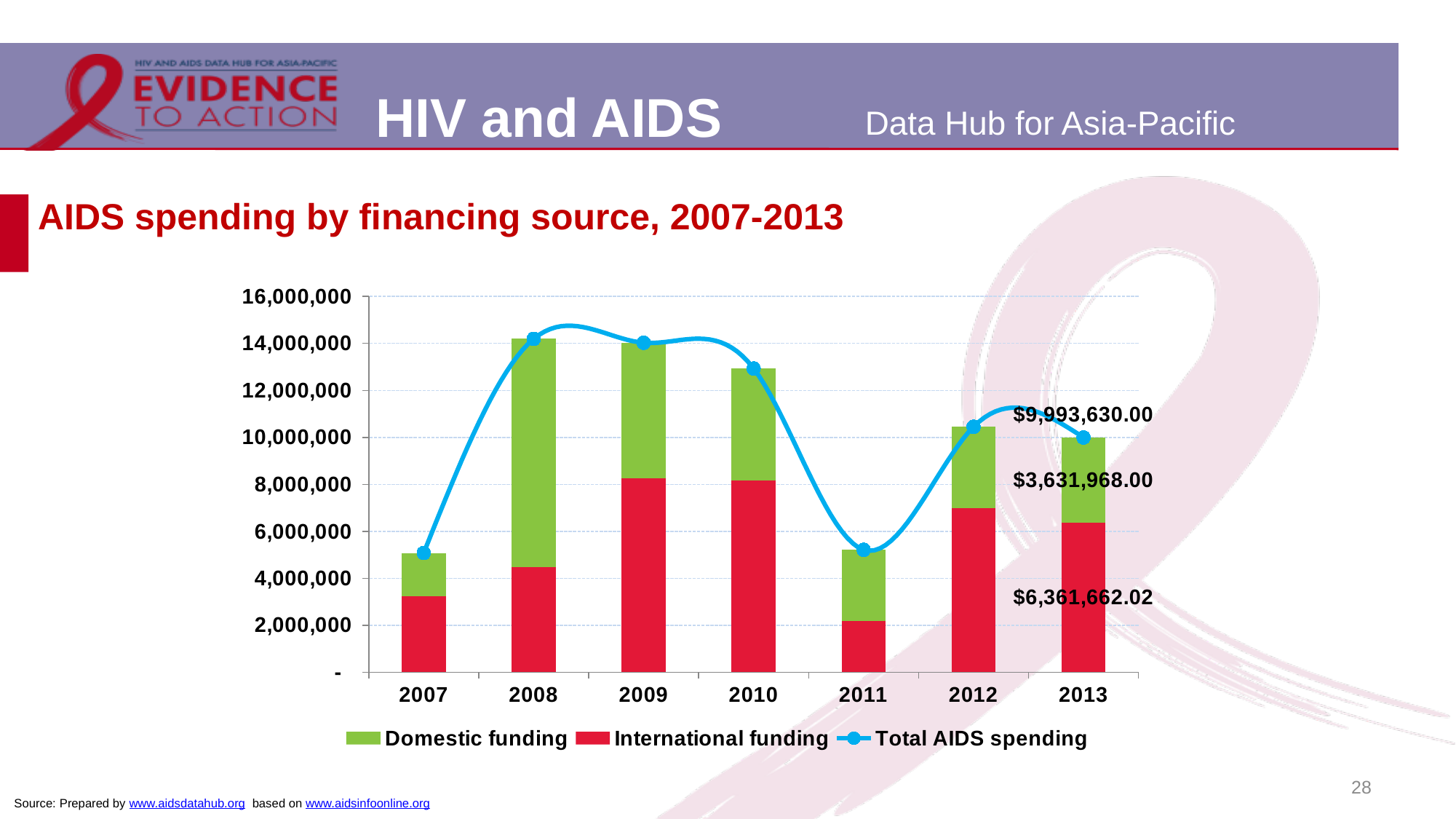
What is the domestic funding value labelled for 2013? $3,631,968.00 Is the total AIDS spending for 2011 greater or less than 6,000,000? less How many years are shown on the x axis? 7 Is the total AIDS spending for 2010 greater or less than 12,000,000? greater In 2013, which is larger: domestic funding or international funding? International funding What kind of chart is this? Stacked bar chart with a line Does total AIDS spending rise or fall from 2008 to 2011? Fall In 2008, which is larger: domestic funding or international funding? Domestic funding What is the international funding value labelled for 2013? $6,361,662.02 How many series does the legend list? 3 What is the total AIDS spending shown for 2013? $9,993,630.00 What is the difference between international funding and domestic funding in 2013? $2,729,694.02